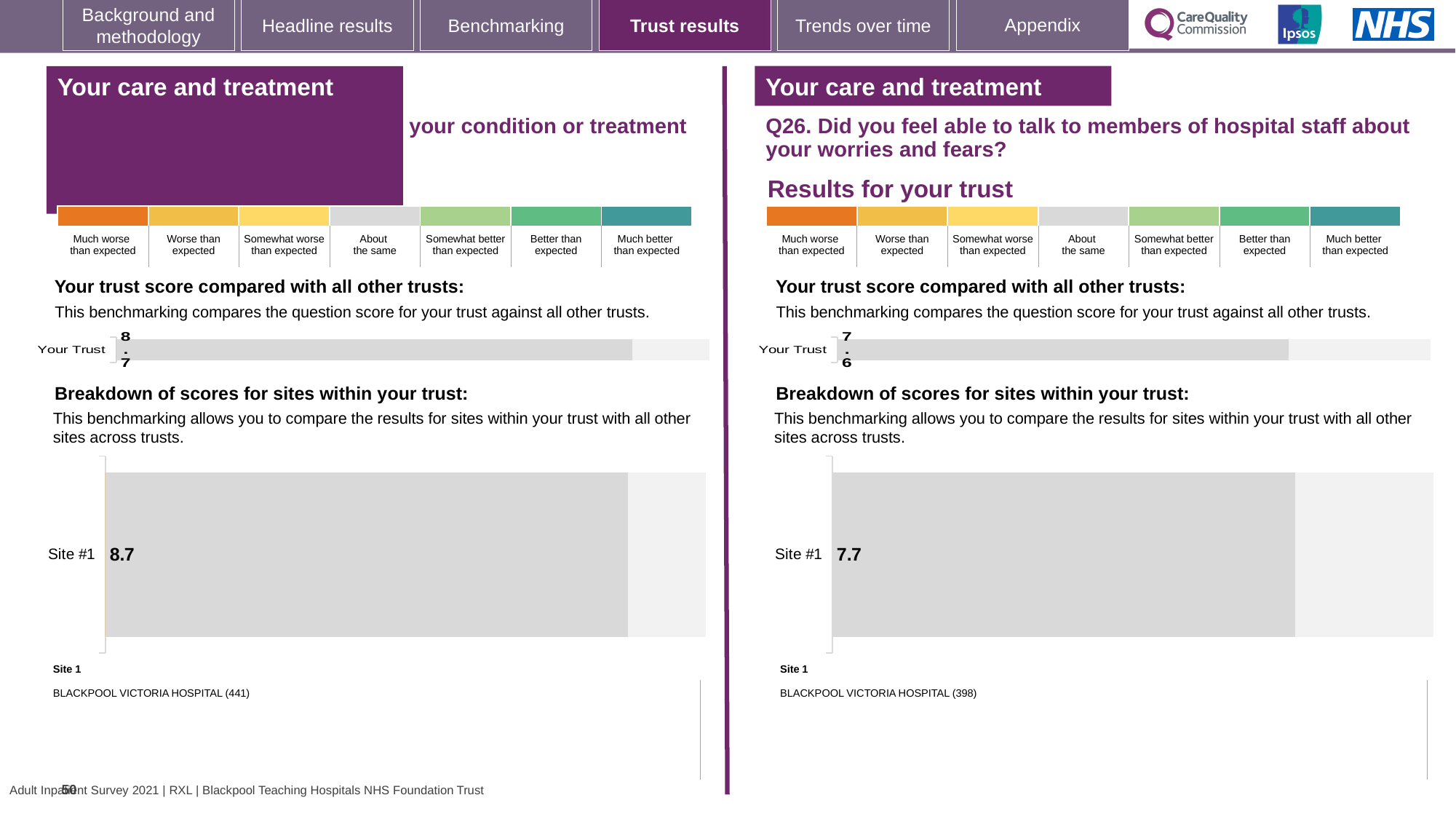
On the left half of the slide, what score is shown for Site #1 in the breakdown of scores for sites within your trust? 8.7 On the right half of the slide (Q26), what score is shown for Site #1 in the breakdown of scores for sites within your trust? 7.7 What type of chart is used to show the Site #1 score on the left half of the slide? Bar chart What is the difference between the Your Trust score on the left half of the slide and the Your Trust score on the right half (Q26)? 1.1 What is the difference between the Site #1 score on the left half of the slide and the Site #1 score on the right half (Q26)? 1.0 On the right half of the slide (Q26), what is the value shown for Your Trust in the trust score comparison chart? 7.6 On the left half of the slide, what is the value shown for Your Trust in the trust score comparison chart? 8.7 On the right half of the slide (Q26), which site name is listed as Site 1 below the breakdown chart? BLACKPOOL VICTORIA HOSPITAL (398) Which is larger: the Site #1 score on the left half of the slide or the Site #1 score on the right half (Q26)? Left half (8.7) On the left half of the slide, what number appears in brackets after BLACKPOOL VICTORIA HOSPITAL under Site 1? 441 How many sites are shown in the breakdown of scores chart on the right half of the slide (Q26)? 1 On the right half of the slide (Q26), what is the difference between the Site #1 score and the Your Trust score? 0.1